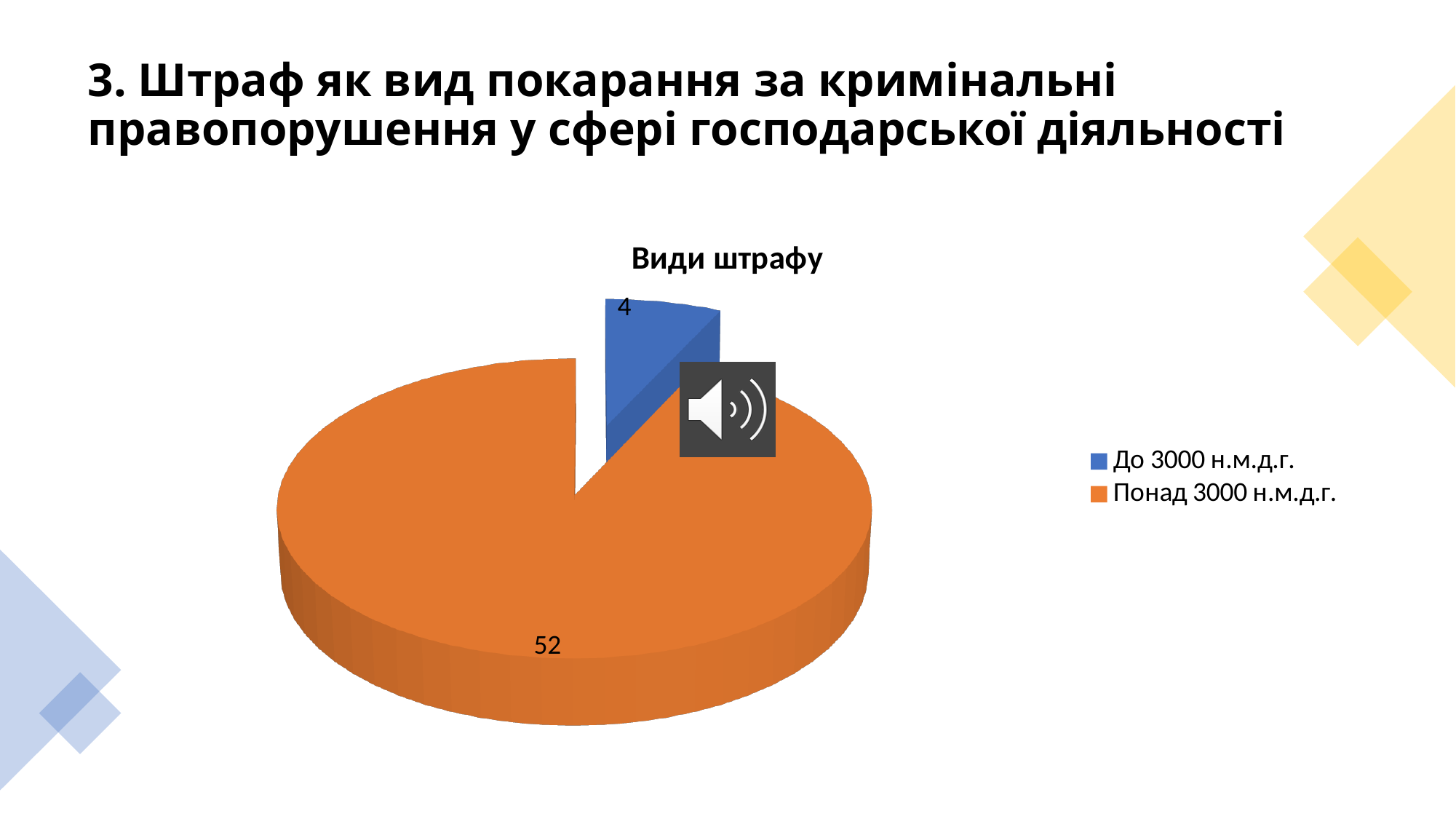
What colour is the slice for "До 3000 н.м.д.г."? Blue What kind of chart is shown on the slide? Pie chart What is the total of the two values shown in the pie chart? 56 Which category has the smallest slice in the pie chart? До 3000 н.м.д.г. Which is larger: the value for "До 3000 н.м.д.г." or the value for "Понад 3000 н.м.д.г."? Понад 3000 н.м.д.г. What is the value for "До 3000 н.м.д.г." in the pie chart? 4 How many entries does the legend of the chart list? 2 What is the difference between the values for "Понад 3000 н.м.д.г." and "До 3000 н.м.д.г."? 48 Which category has the largest slice in the pie chart? Понад 3000 н.м.д.г. How many slices does the pie chart have? 2 What is the title of the chart? Види штрафу What is the value for "Понад 3000 н.м.д.г." in the pie chart? 52